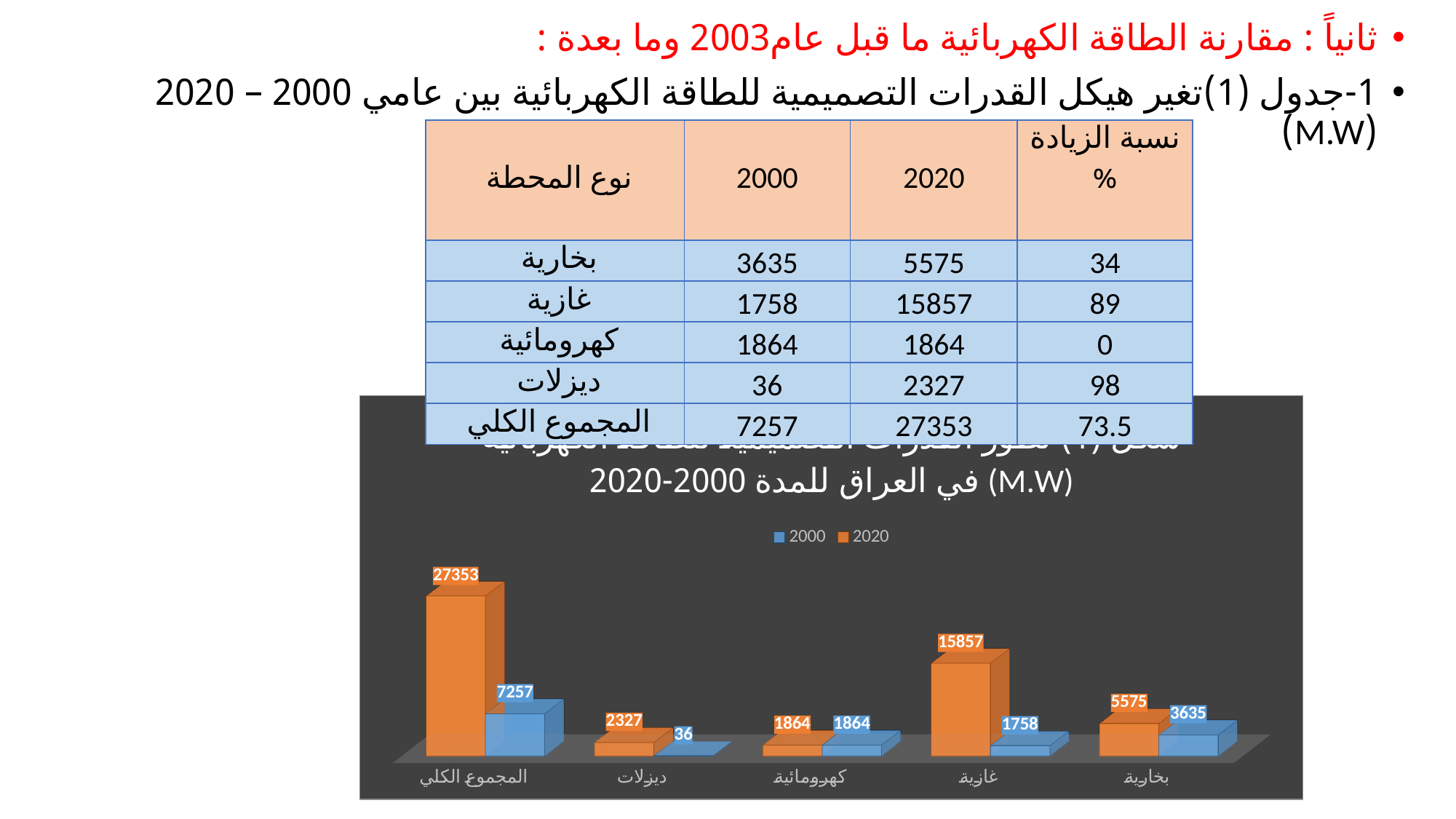
Which is larger for بخارية: the 2000 value or the 2020 value? 2020 Which colour represents the 2020 series in the chart? orange What is the value for ديزلات in the 2000 series? 36 Which category has the highest value in the 2020 series? المجموع الكلي How many series does the chart legend list? 2 What is the value for غازية in the 2020 series? 15857 What is the value for المجموع الكلي in the 2000 series? 7257 Which category has the lowest value in the 2000 series? ديزلات What is the value for بخارية in the 2020 series? 5575 What is the difference between the 2020 and 2000 values for غازية? 14099 How many categories are shown on the chart's x axis? 5 What kind of chart is shown on the slide? bar chart